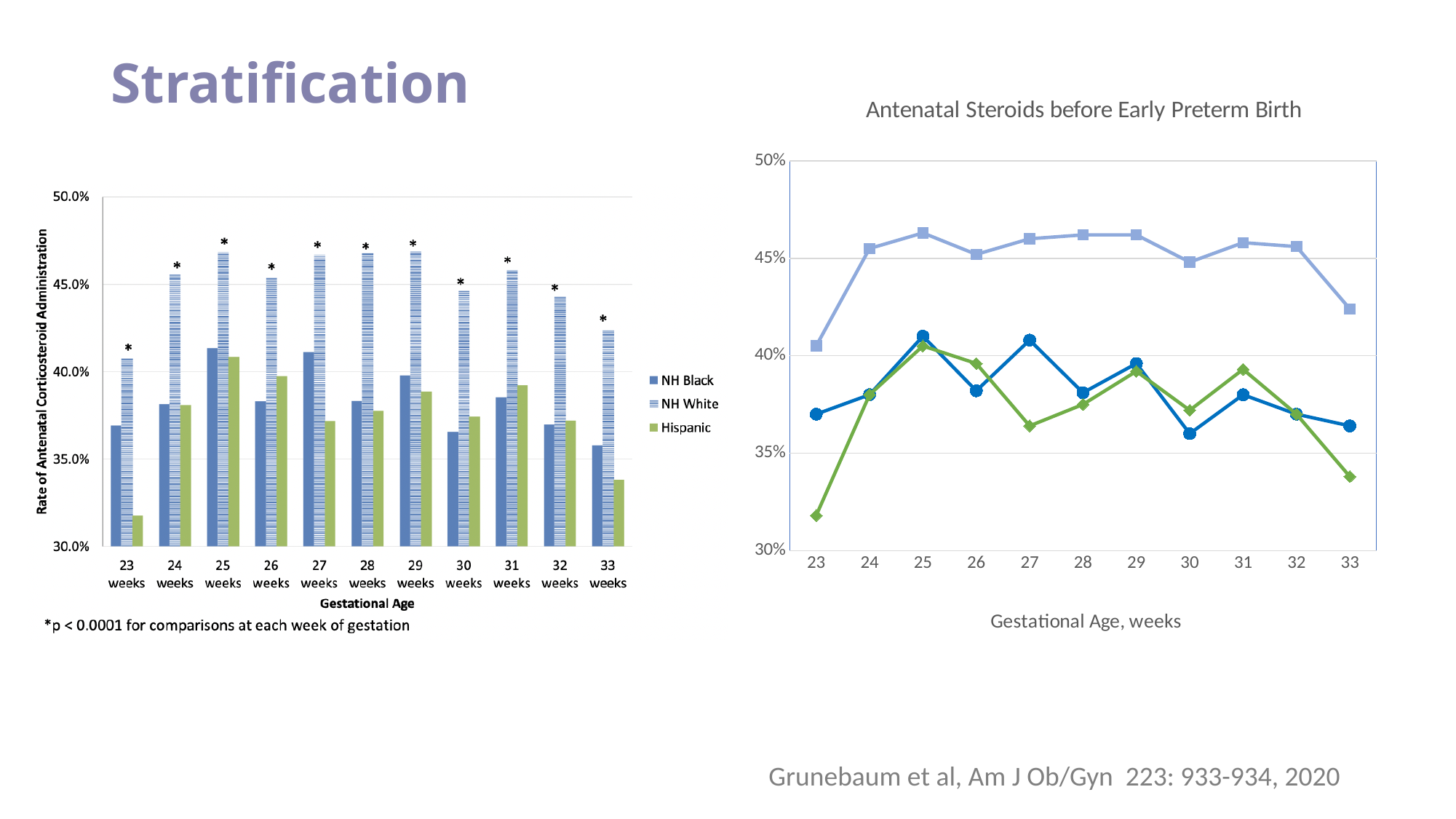
In the left bar chart, which is larger at 33 weeks: the NH Black bar or the Hispanic bar? NH Black What kind of chart is the chart titled 'Antenatal Steroids before Early Preterm Birth'? line chart In the chart titled 'Antenatal Steroids before Early Preterm Birth', does the top (light blue) line rise or fall between 32 and 33 weeks? fall In the left bar chart, which series has the highest bar at 25 weeks? NH White In the left bar chart, at which gestational age is the Hispanic bar lowest? 23 weeks In the left bar chart, how many series does the legend list? 3 In the left bar chart, is the value for NH Black at 25 weeks greater or less than 40.0%? greater In the left bar chart, at which gestational age is the NH White bar lowest? 23 weeks What kind of chart is the chart on the left side of the slide? bar chart In the chart titled 'Antenatal Steroids before Early Preterm Birth', is the value of the green line at 33 weeks greater or less than 35%? less In the left bar chart, how many gestational age categories are shown on the x axis? 11 In the left bar chart, is the value for Hispanic at 23 weeks greater or less than 35.0%? less